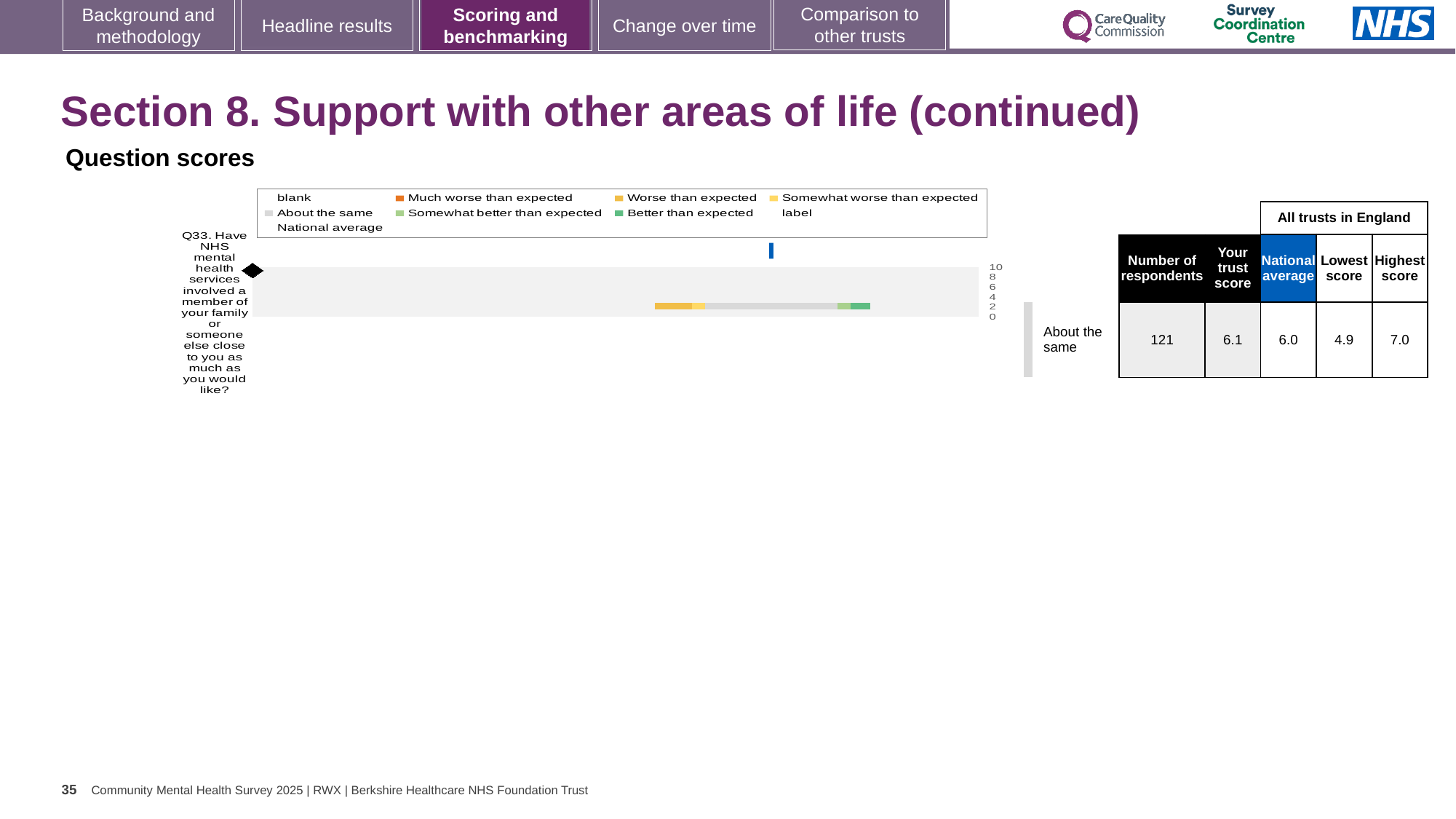
What is the national average score for Q33? 6.0 What is the highest score among all trusts in England for Q33? 7.0 Is the trust's score for Q33 greater or less than 5 on the chart's axis? greater Which benchmarking category is the trust's Q33 score placed in? About the same What is the trust's score for Q33 (Have NHS mental health services involved a member of your family or someone else close to you as much as you would like?)? 6.1 How many respondents answered Q33? 121 What is the difference between the highest and lowest trust scores in England for Q33? 2.1 Which is larger for Q33, the trust's score or the national average? the trust's score Which legend entry in the question scores chart is shown in orange? Much worse than expected What kind of chart is used to show the Q33 question score? bar chart How many survey questions are plotted in the question scores chart? 1 What is the lowest score among all trusts in England for Q33? 4.9